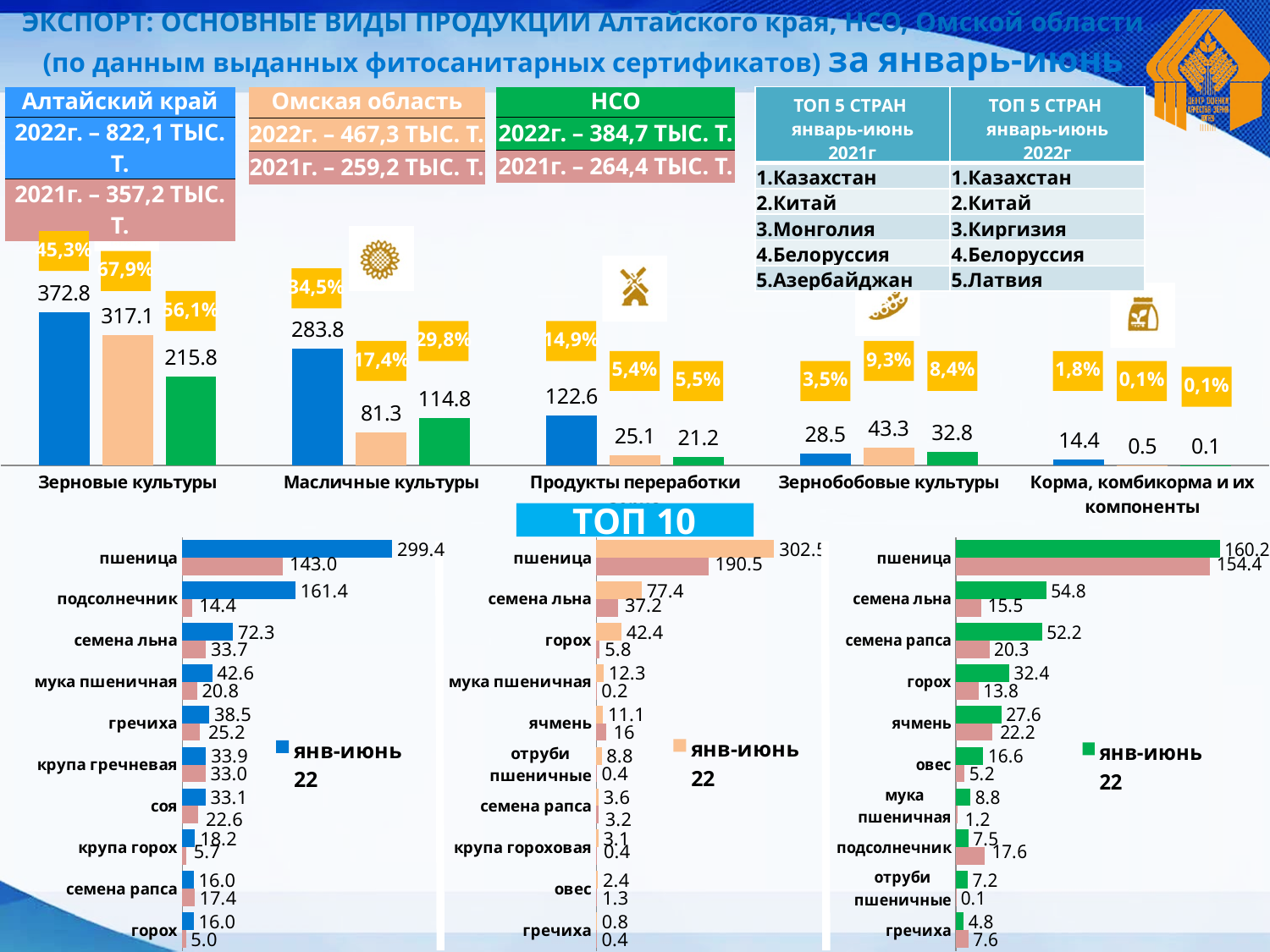
In the top bar chart, what is the value of the blue bar for Зерновые культуры? 372.8 In the bottom-left horizontal bar chart, which category has the highest янв-июнь 22 value? пшеница In the bottom-middle horizontal bar chart, what is the янв-июнь 22 value for семена льна? 77.4 In the top bar chart, what is the value of the green bar for Масличные культуры? 114.8 In the top bar chart, what is the difference between the blue bar and the orange bar for Продукты переработки? 97.5 What type of chart is the bottom-right chart? bar chart In the top bar chart, which category has the lowest green bar value? Корма, комбикорма и их компоненты In the bottom-right horizontal bar chart, what is the янв-июнь 22 value for семена рапса? 52.2 In the top bar chart, for Зернобобовые культуры, which is larger: the blue bar or the orange bar? the orange bar In the bottom-middle horizontal bar chart, what is the difference between the two values shown for горох? 36.6 How many categories are shown along the x axis of the top bar chart? 5 In the bottom-left horizontal bar chart, what is the янв-июнь 22 value for подсолнечник? 161.4